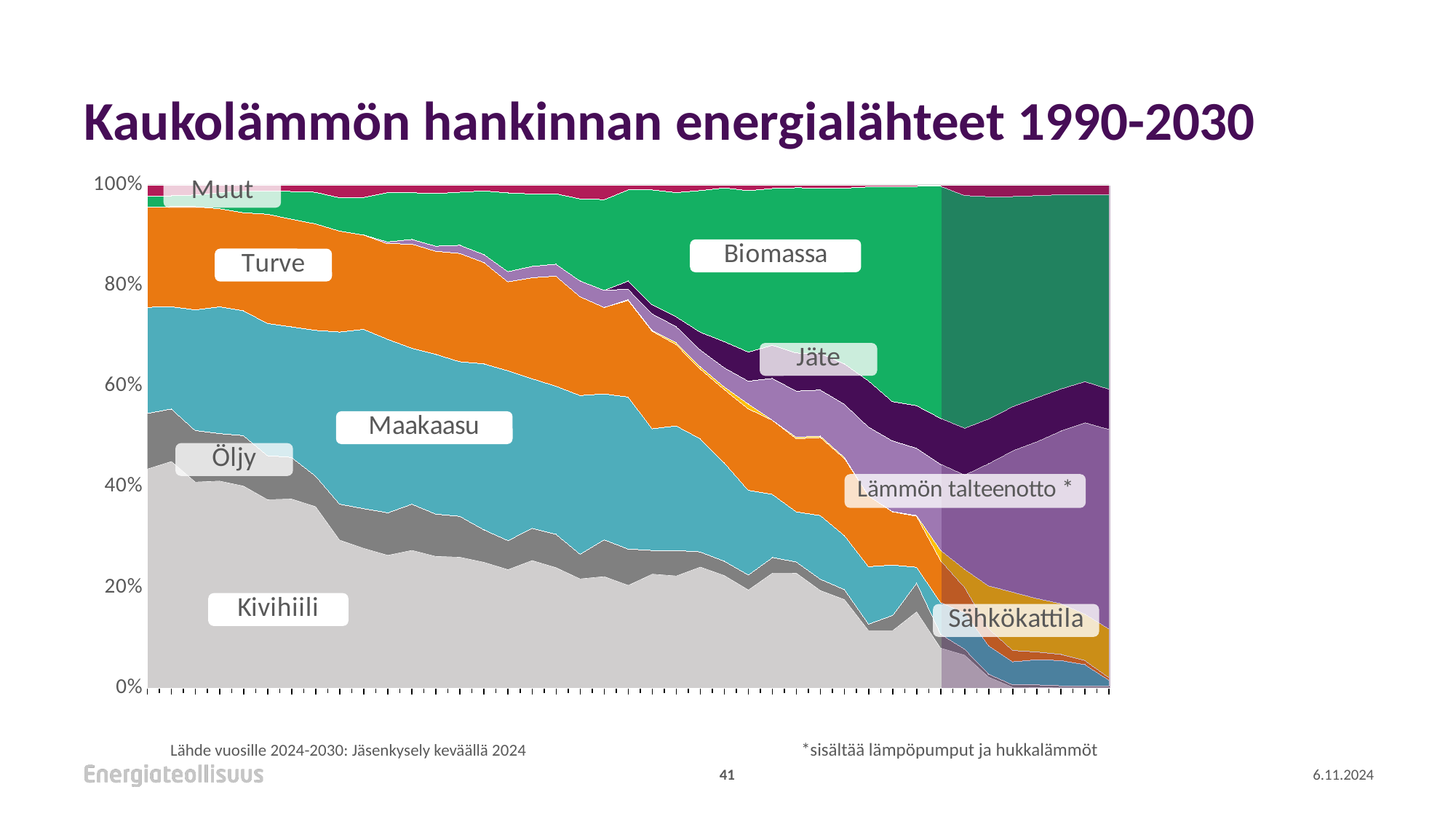
Does the share of Lämmön talteenotto rise or fall towards the end of the period? Rise What is the highest value shown on the vertical axis? 100% What is the title of the chart? Kaukolämmön hankinnan energialähteet 1990-2030 Does the share of Maakaasu rise or fall over the period 1990-2030? Fall Does the share of Kivihiili rise or fall over the period 1990-2030? Fall At the end of the period, is the share of Kivihiili greater or less than 20%? less At the start of the period, is the share of Kivihiili greater or less than 20%? greater What kind of chart is shown on the slide? Stacked area chart Which energy source is plotted at the bottom of the stacked area chart? Kivihiili How many energy source series are labelled on the chart? 9 Which energy source has the largest share at the start of the period (1990)? Kivihiili